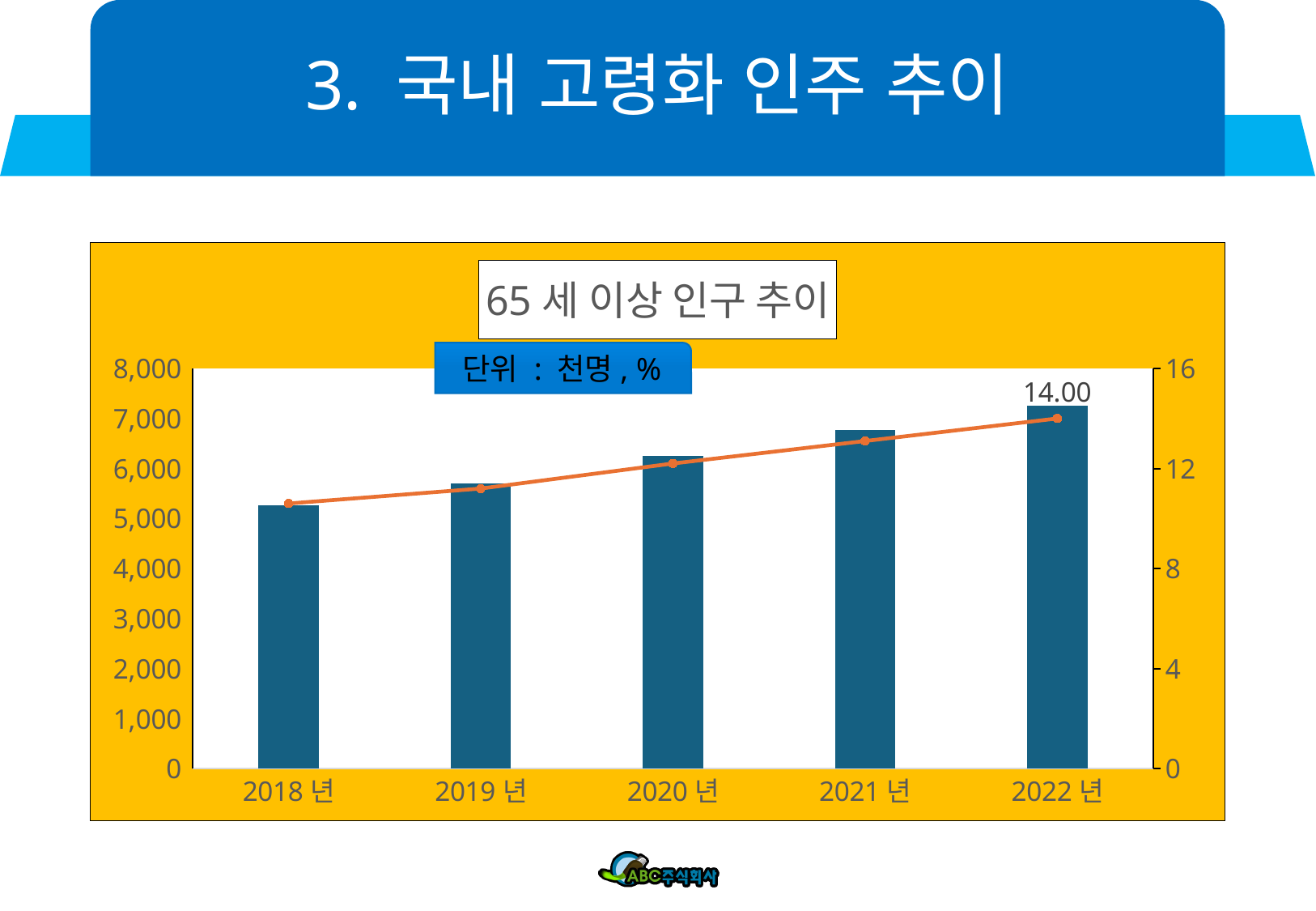
Is the bar value for 2018 년 greater or less than 6,000? less What is the data label shown on the line at 2022 년? 14.00 Do the bar values rise or fall from 2018 년 to 2022 년? Rise Is the bar value for 2021 년 greater or less than 7,000? less What kind of chart is this? Bar chart with a line Which year has the tallest bar? 2022 년 Which year has the shortest bar? 2018 년 How many years are shown on the x axis? 5 Is the bar value for 2022 년 greater or less than 7,000? greater Which has the larger bar value, 2019 년 or 2021 년? 2021 년 What is the title of the chart? 65 세 이상 인구 추이